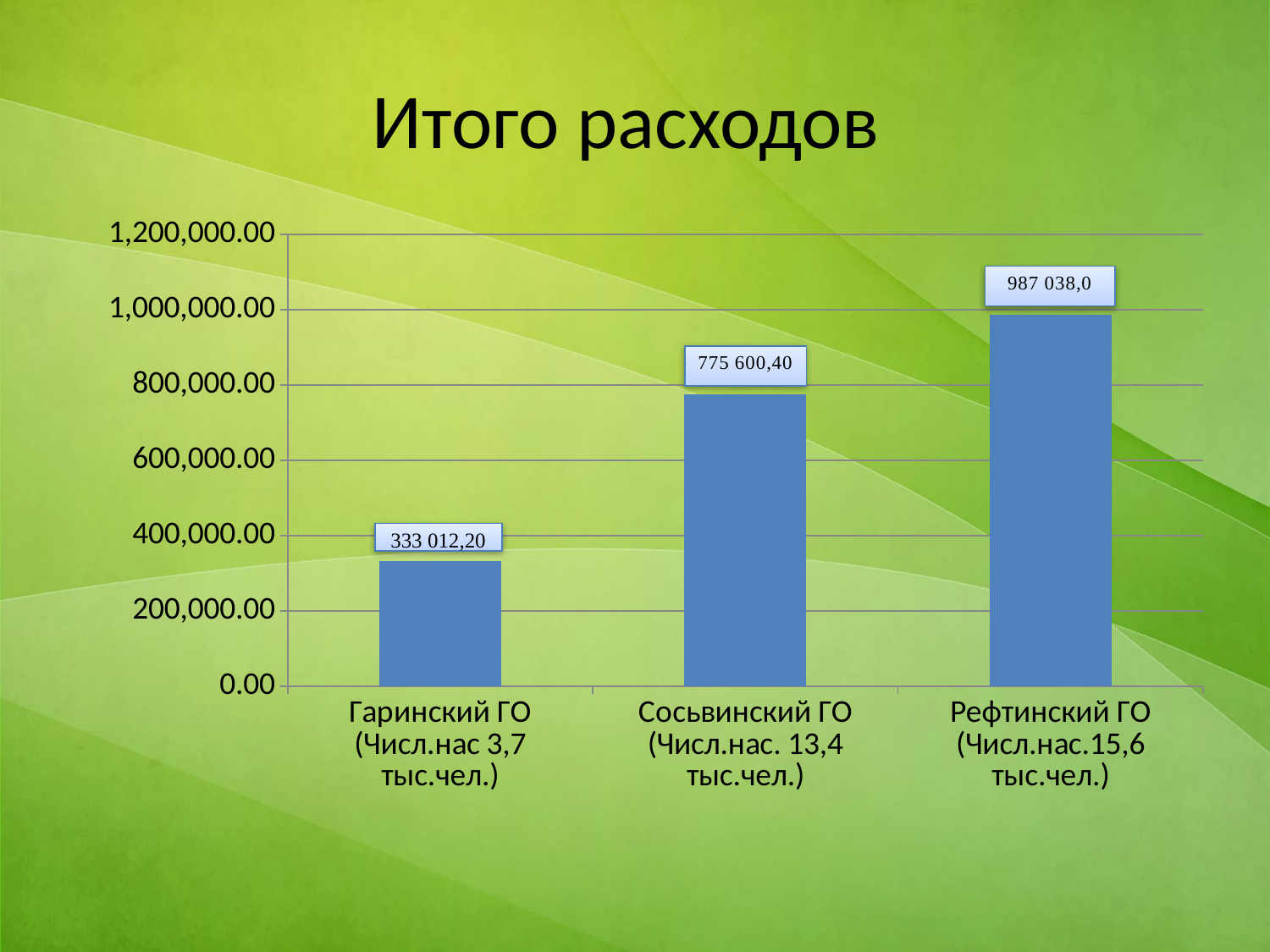
How many categories are shown in the chart? 3 What is the difference between the values for Сосьвинский ГО and Гаринский ГО? 442 588,20 What is the value for Гаринский ГО? 333 012,20 Which category has the lowest value? Гаринский ГО Which category has the highest value? Рефтинский ГО What is the value for Сосьвинский ГО? 775 600,40 What is the value for Рефтинский ГО? 987 038,0 What is the title of the slide? Итого расходов Which is larger, the value for Сосьвинский ГО or the value for Гаринский ГО? Сосьвинский ГО Is the value for Рефтинский ГО greater or less than 1,000,000.00? less What is the difference between the values for Рефтинский ГО and Сосьвинский ГО? 211 437,60 What kind of chart is shown on the slide? bar chart